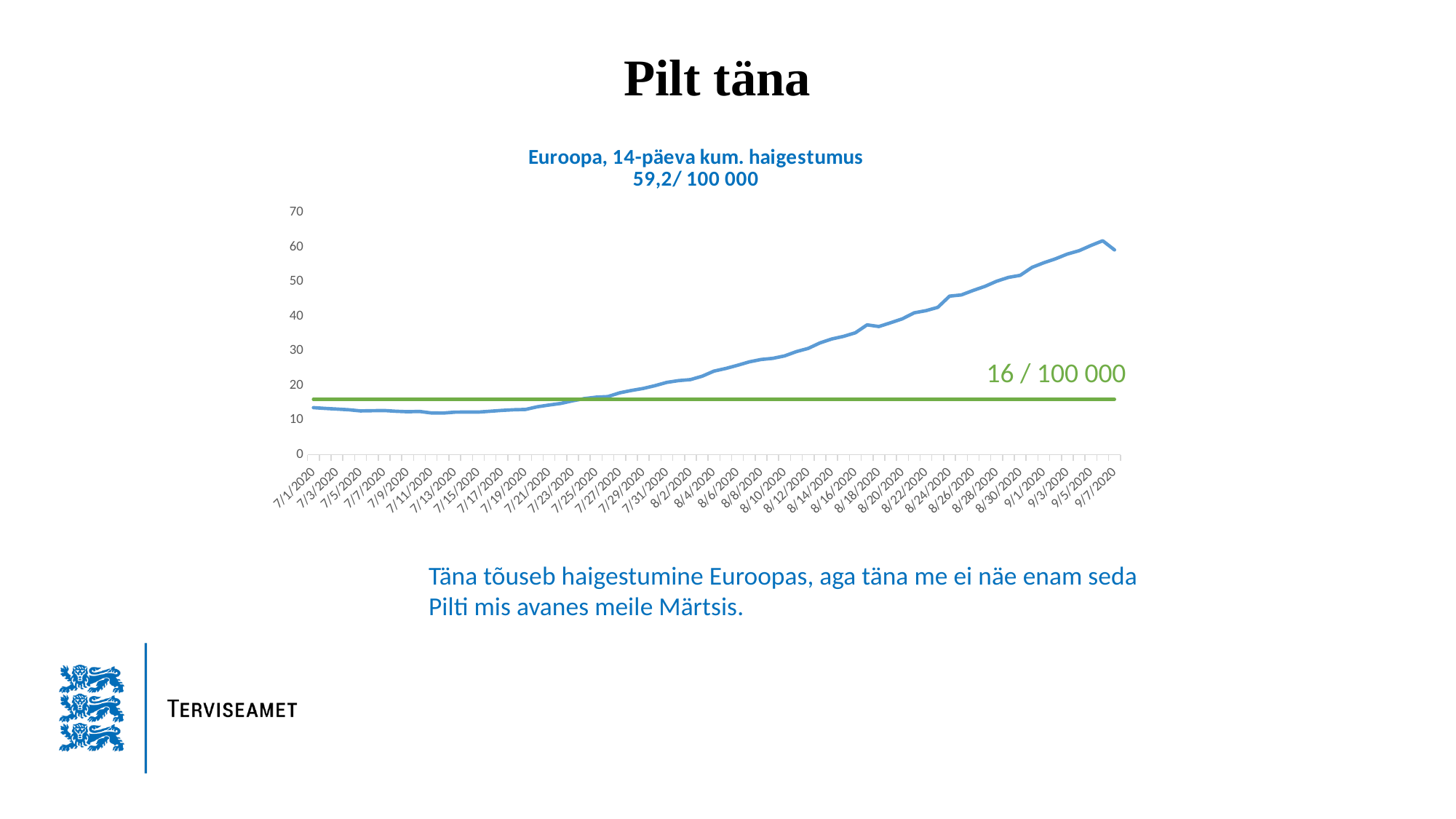
Is the value for 8/16/2020 greater or less than 30? greater Is the value for 7/1/2020 greater or less than 20? less Which is larger, the value for 9/7/2020 or the value for 7/1/2020? 9/7/2020 Is the value for 8/10/2020 greater or less than 20? greater What kind of chart is shown on the slide? line chart What value is labelled on the green horizontal line? 16 / 100 000 Which is larger, the value for 8/2/2020 or the value for 8/16/2020? 8/16/2020 What is the title of the chart? Euroopa, 14-päeva kum. haigestumus 59,2/ 100 000 What colour is the horizontal reference line on the chart? green Does the blue line generally rise or fall from 7/1/2020 to 9/7/2020? rise